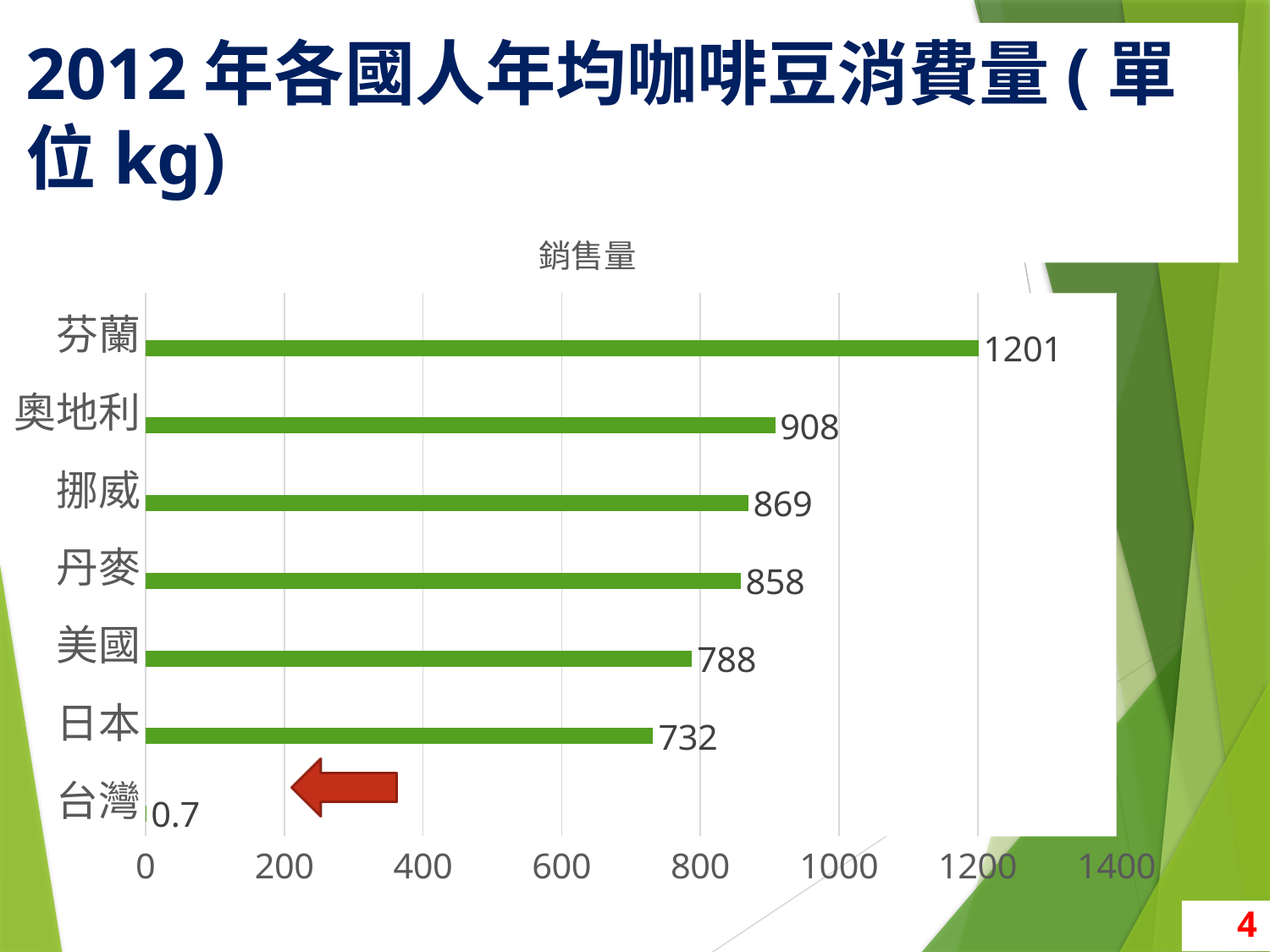
What is the difference between the values for 芬蘭 and 奧地利? 293 Which category has the lowest value? 台灣 What is the value for 日本? 732 What is the value for 台灣? 0.7 Which category has the highest value? 芬蘭 What is the value for 奧地利? 908 Which is larger, the value for 美國 or the value for 日本? 美國 How many categories are shown in the chart? 7 What is the value for 芬蘭? 1201 What is the title of the chart? 銷售量 What kind of chart is shown on the slide? bar chart What is the difference between the values for 挪威 and 丹麥? 11